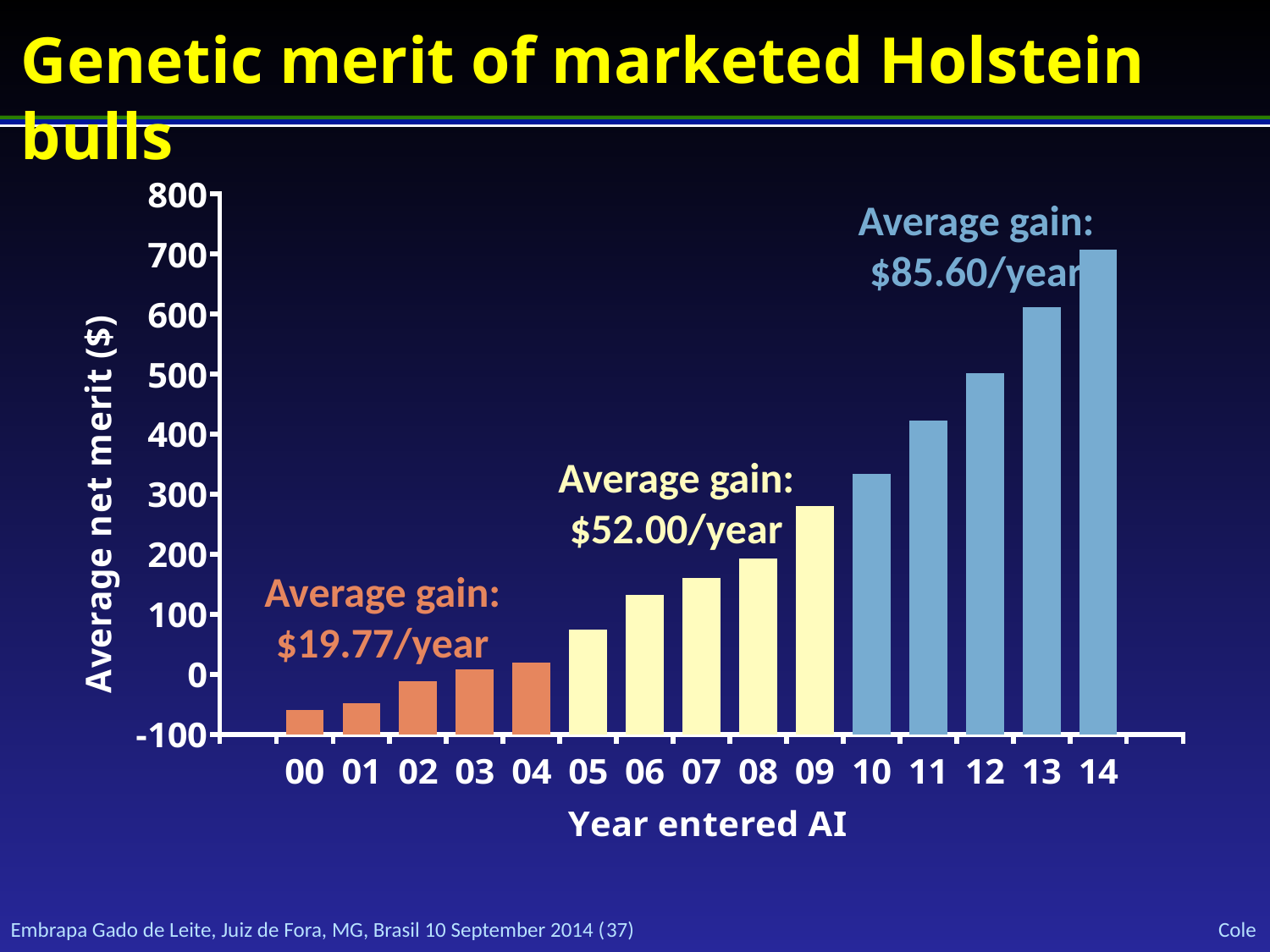
Is the average net merit for year 14 greater or less than 600? greater Which year entered AI has the highest average net merit? 14 Which year entered AI has the lowest average net merit? 00 What is the label of the y axis? Average net merit ($) Is the average net merit for year 00 greater or less than 0? less Which has the larger average net merit, year 09 or year 10? 10 Do the average net merit values rise or fall from year 00 to year 14? rise Is the average net merit for year 05 greater or less than 100? less What average gain per year is annotated for the blue bars (years 10 to 14)? $85.60/year How many years (bars) are plotted on the x axis? 15 What kind of chart is shown on the slide? bar chart